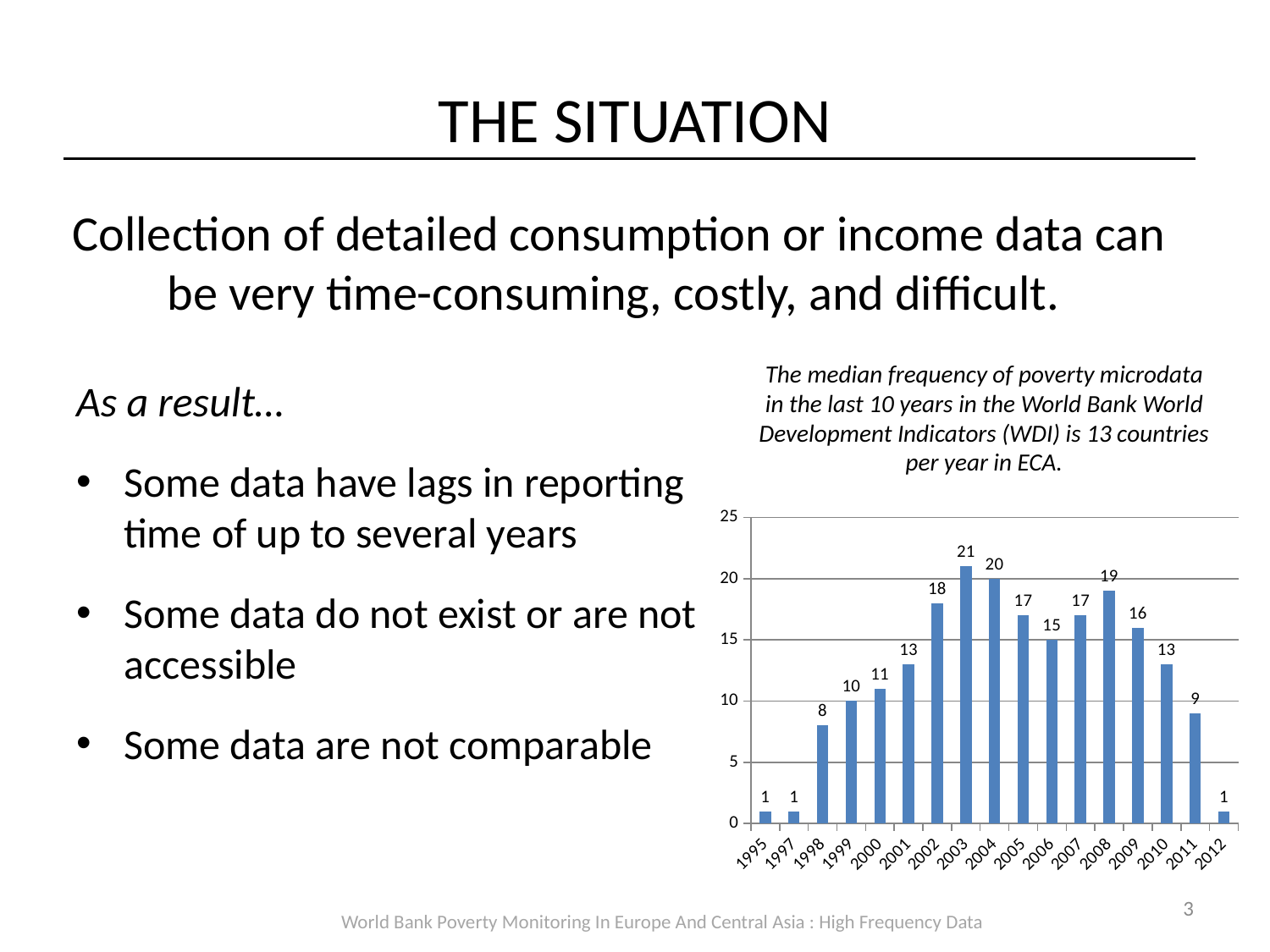
How many years are shown on the x axis? 17 Which is larger, the value for 2004 or the value for 2009? 2004 Which year has the highest value? 2003 What kind of chart is shown on the slide? bar chart Do the values rise or fall from 1998 to 2003? rise What is the difference between the values for 2002 and 2006? 3 Is the value for 2005 greater or less than 15? greater What is the difference between the values for 2003 and 2011? 12 What is the value for 1998? 8 What is the value for 2012? 1 What is the value for 2003? 21 What is the value for 2008? 19